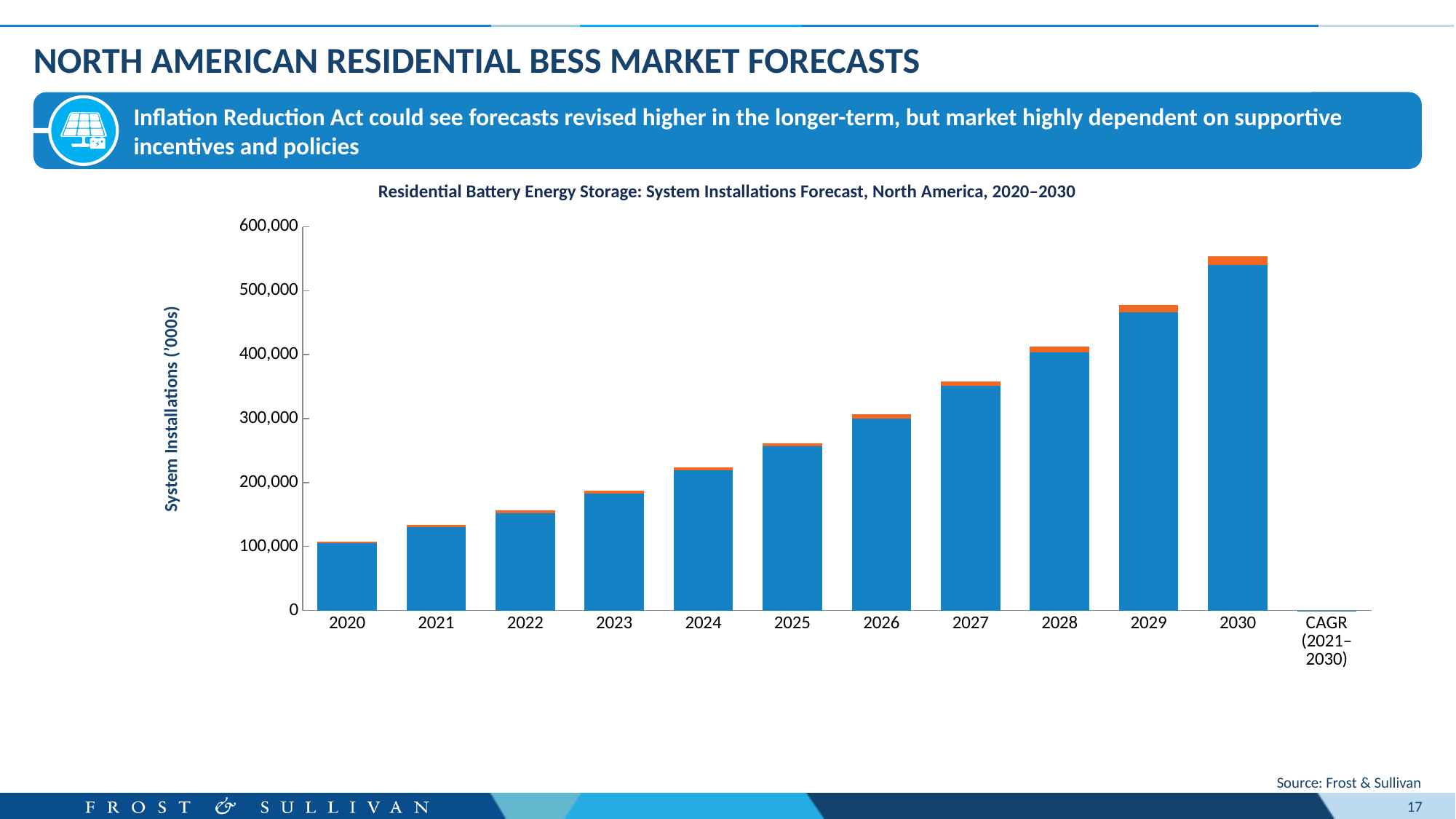
What kind of chart is shown on the slide? bar chart Is the total value for 2022 greater or less than 200,000? less Is the total value for 2027 greater or less than 400,000? less Which year has the lowest total system installations? 2020 How many years from 2020 to 2030 have bars plotted? 11 Is the total value for 2030 greater or less than 500,000? greater What is the label on the vertical axis? System Installations ('000s) Do system installations rise or fall from 2020 to 2030? rise Which year has the larger total, 2023 or 2026? 2026 Which year has the highest total system installations? 2030